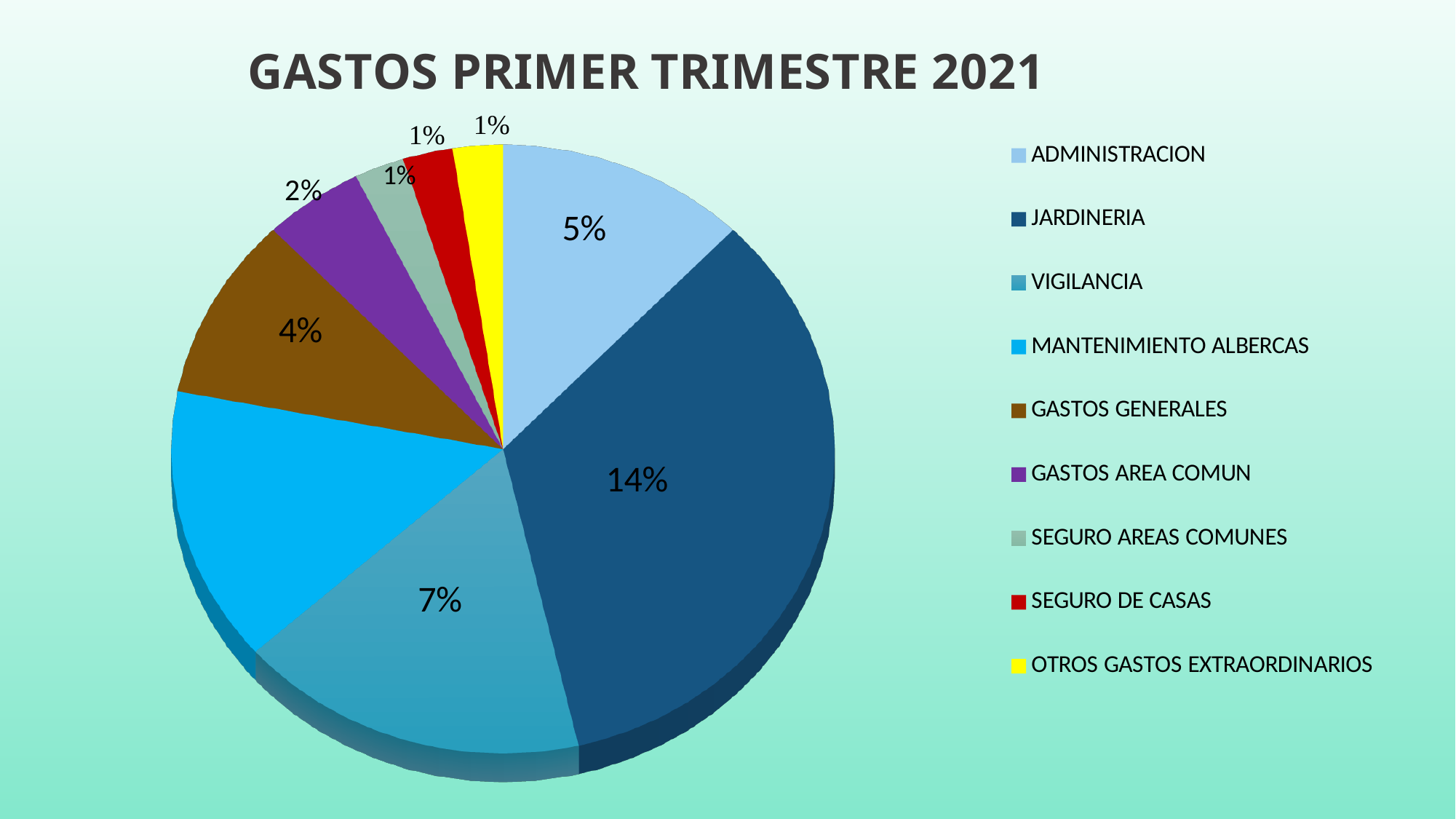
Which category has the largest slice of the pie? JARDINERIA What is the title of the chart? GASTOS PRIMER TRIMESTRE 2021 What kind of chart is shown on the slide? pie chart How many categories does the legend list? 9 What is the value shown for JARDINERIA? 14% What is the value shown for GASTOS AREA COMUN? 2% Which is larger, the value for JARDINERIA or the value for VIGILANCIA? JARDINERIA What is the difference between the values for JARDINERIA and ADMINISTRACION? 9% What is the value shown for ADMINISTRACION? 5% What is the value shown for VIGILANCIA? 7% What is the value shown for SEGURO DE CASAS? 1% What is the value shown for GASTOS GENERALES? 4%